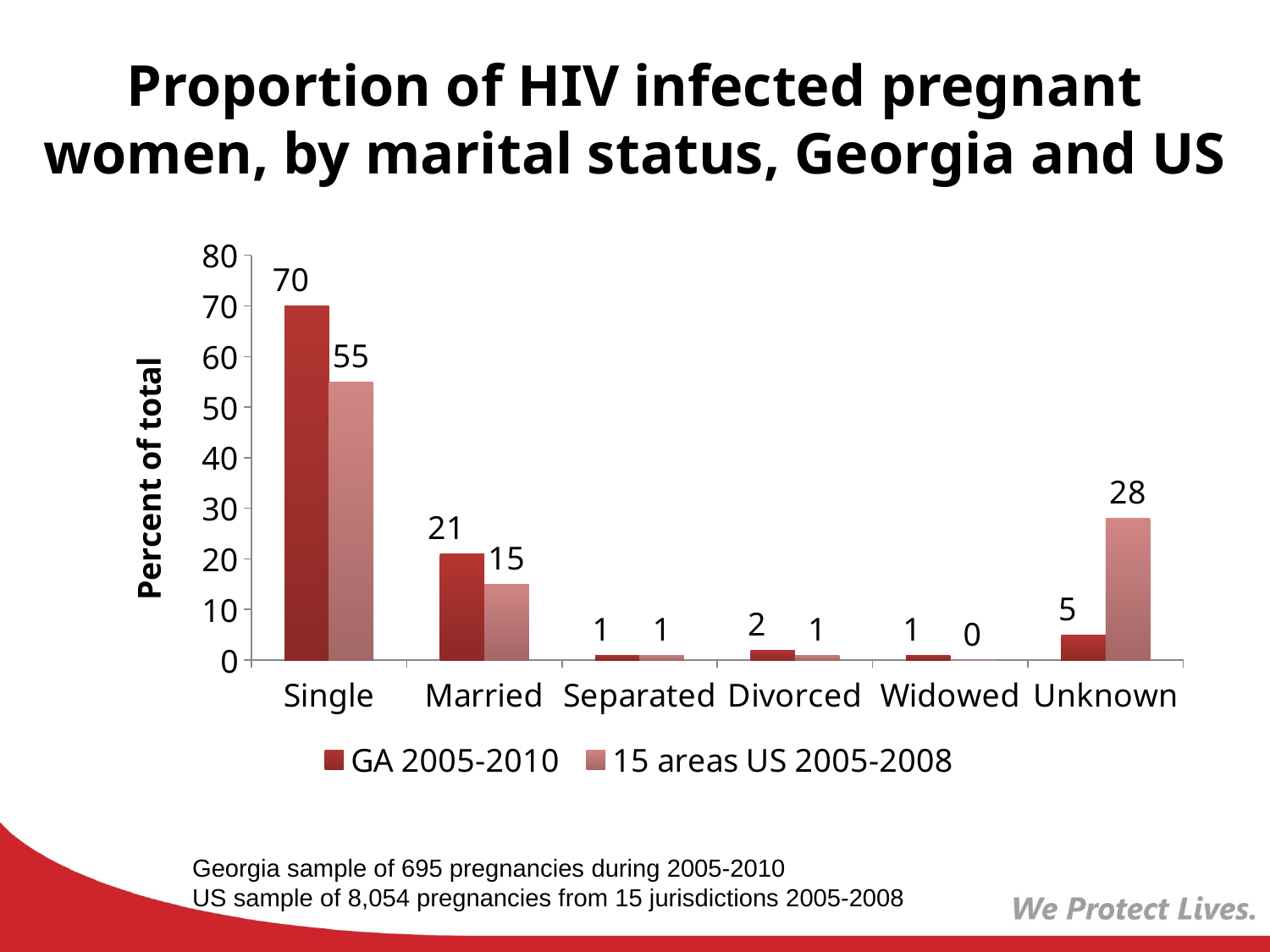
For Married, which series has the larger value, GA 2005-2010 or 15 areas US 2005-2008? GA 2005-2010 What kind of chart is shown on the slide? Bar chart Which marital status category has the lowest value in the 15 areas US 2005-2008 series? Widowed What is the value for Married in the 15 areas US 2005-2008 series? 15 Is the value for Single in the GA 2005-2010 series greater or less than 60? greater What is the value for Single in the GA 2005-2010 series? 70 How many marital status categories are shown on the x axis? 6 What is the difference between the 15 areas US 2005-2008 and GA 2005-2010 values for Unknown? 23 What is the difference between the GA 2005-2010 and 15 areas US 2005-2008 values for Single? 15 What is the value for Unknown in the 15 areas US 2005-2008 series? 28 How many series does the legend list? 2 Which marital status category has the highest value in the GA 2005-2010 series? Single